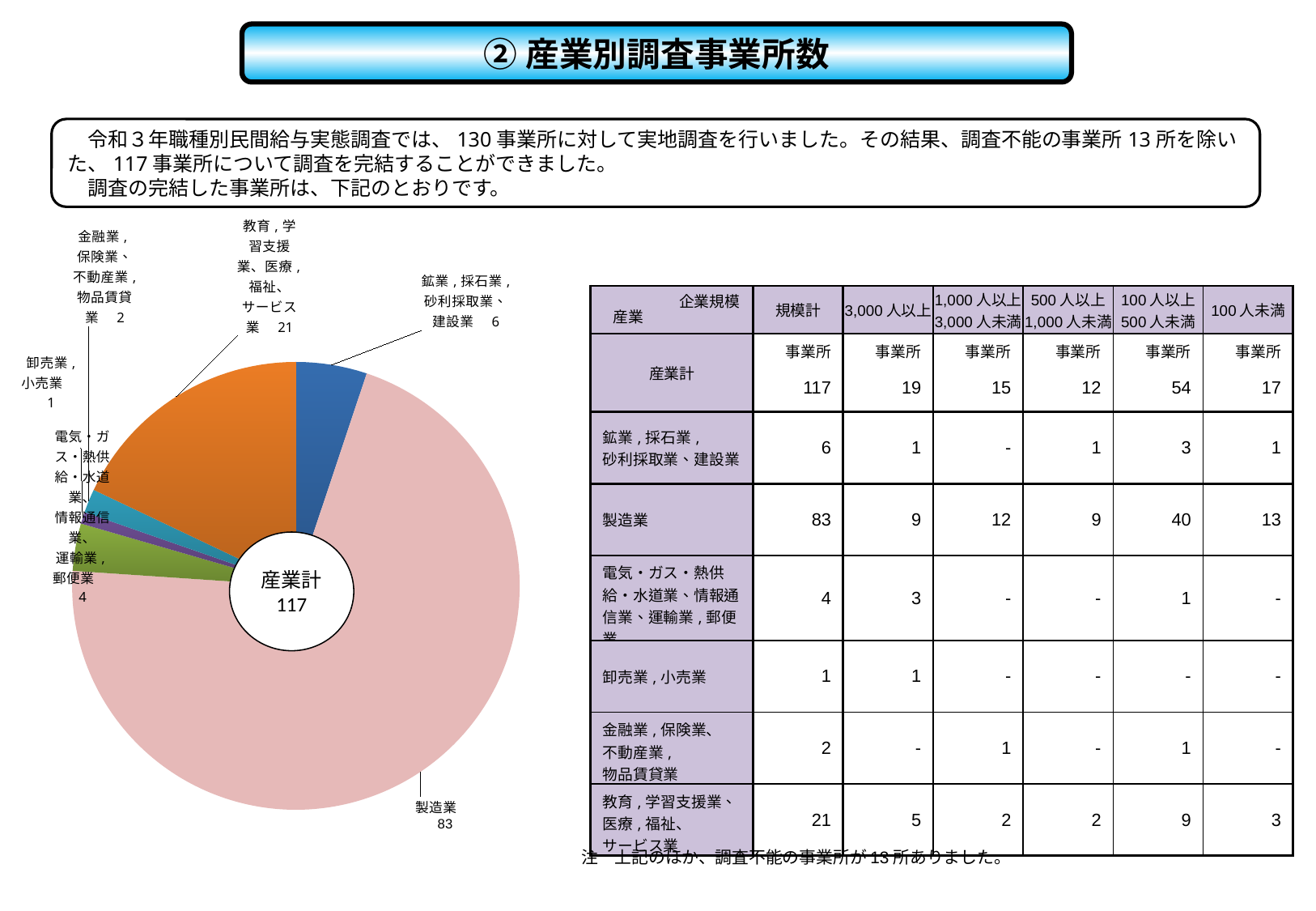
In the pie chart, how many establishments are in 製造業? 83 In the pie chart, which is larger: 鉱業,採石業,砂利採取業、建設業 or 金融業,保険業、不動産業,物品賃貸業? 鉱業,採石業,砂利採取業、建設業 What total is shown in the centre of the pie chart? 117 How many industry categories are shown in the pie chart? 6 In the pie chart, what is the difference between 製造業 and 教育,学習支援業、医療,福祉、サービス業? 62 In the pie chart, what is the value for 鉱業,採石業,砂利採取業、建設業? 6 In the pie chart, what is the value for 卸売業,小売業? 1 What label appears in the centre of the pie chart? 産業計 117 Which industry has the largest slice in the pie chart? 製造業 In the pie chart, what is the value for 教育,学習支援業、医療,福祉、サービス業? 21 What type of chart is shown on the left of the slide? Pie chart Which industry has the smallest slice in the pie chart? 卸売業,小売業